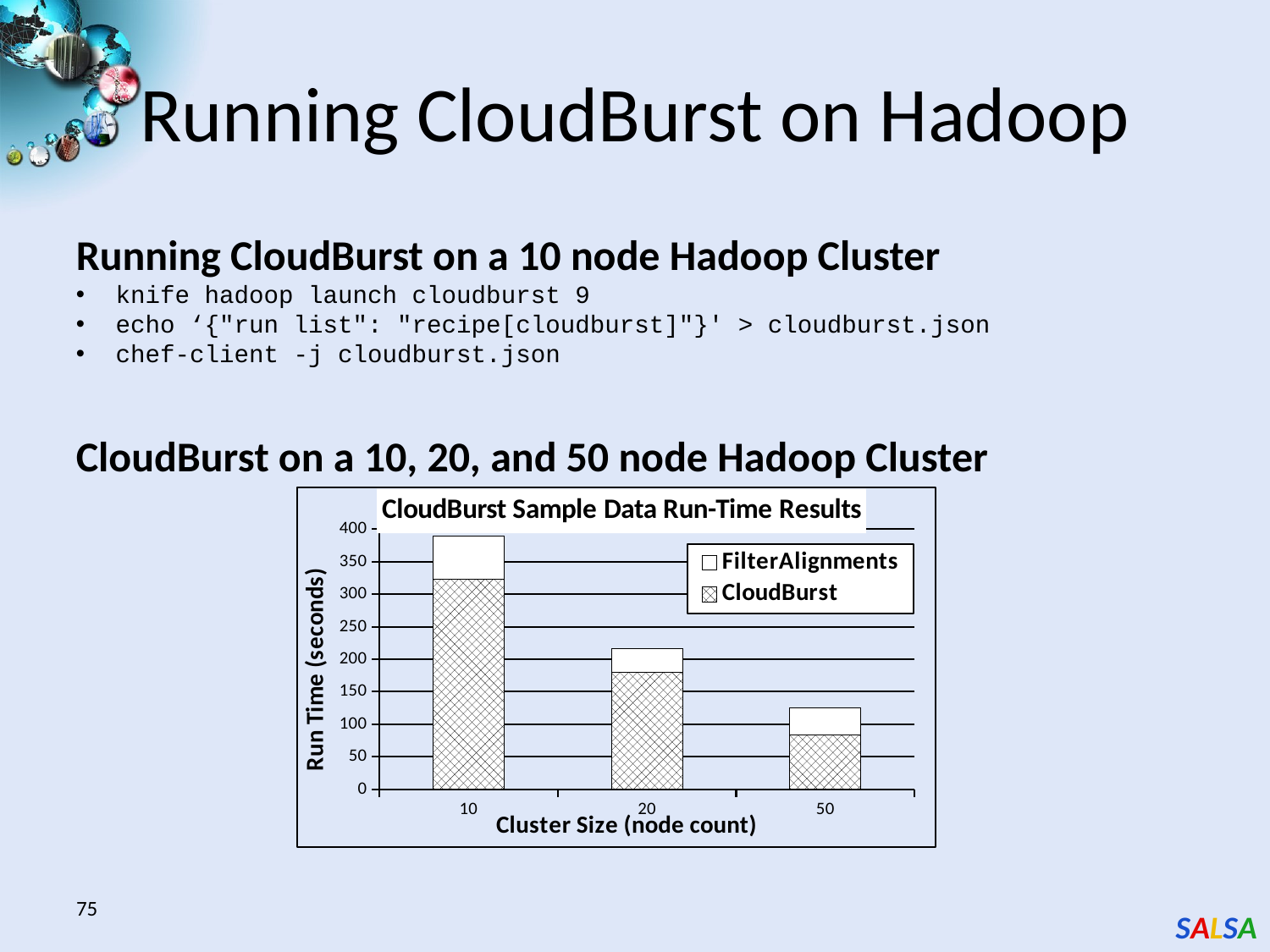
Does the total run time rise or fall as the cluster size increases along the x axis? fall Which cluster size has the highest total run time? 10 What kind of chart is shown on the slide? stacked bar chart How many series does the chart's legend list? 2 Is the total run time for the 50 node cluster greater or less than 100 seconds? greater Which is larger, the CloudBurst run time for the 20 node cluster or the total run time for the 50 node cluster? CloudBurst run time for the 20 node cluster Is the CloudBurst run time for the 20 node cluster greater or less than 200 seconds? less What is the title of the chart? CloudBurst Sample Data Run-Time Results How many cluster sizes are plotted on the x axis? 3 Which cluster size has the lowest total run time? 50 Is the total run time for the 10 node cluster greater or less than 350 seconds? greater Which two series are listed in the chart's legend? FilterAlignments and CloudBurst